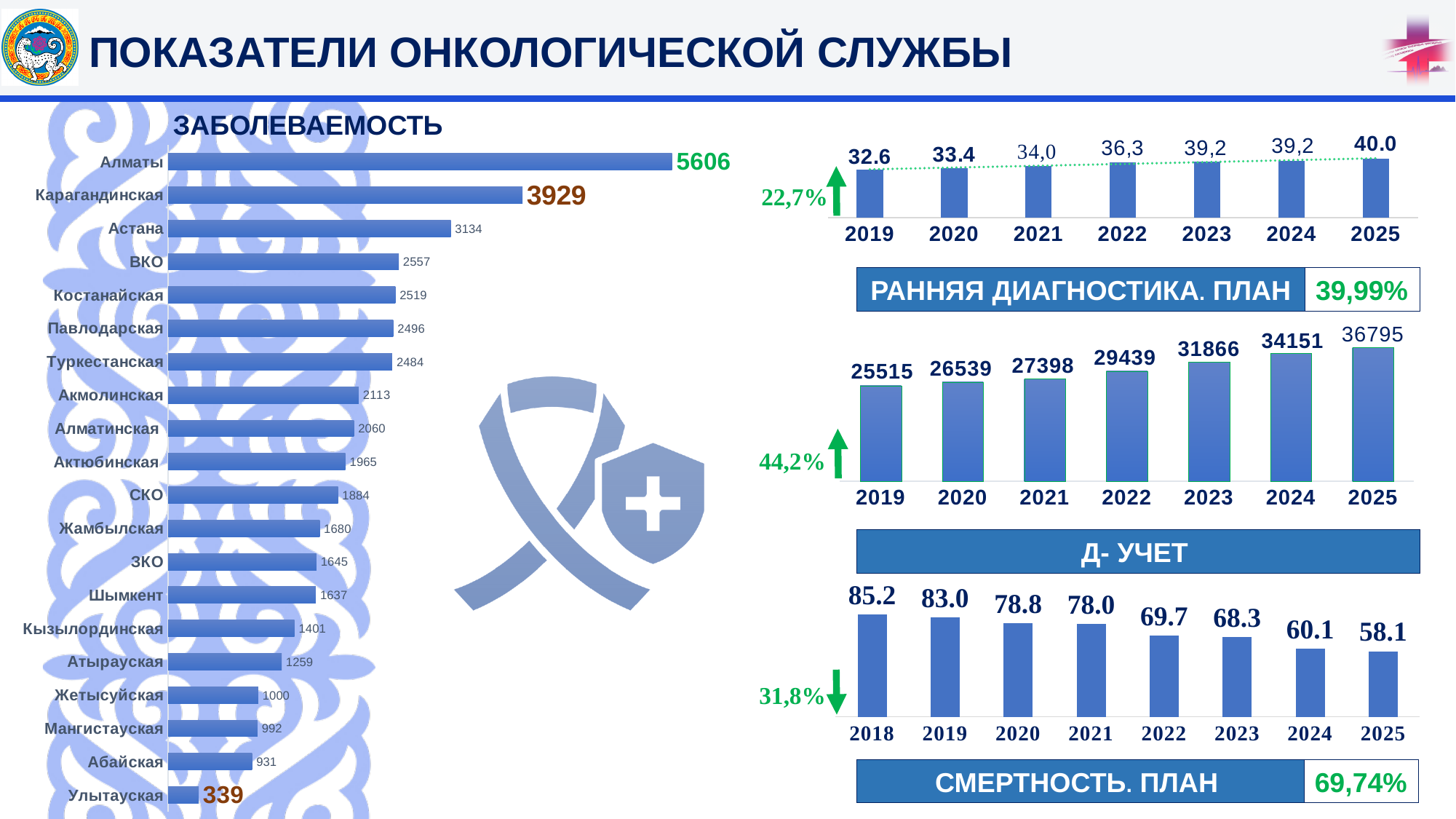
In the ЗАБОЛЕВАЕМОСТЬ chart, how many regions are listed? 20 In the ЗАБОЛЕВАЕМОСТЬ chart, what is the difference between Алматы and Карагандинская? 1677 In the top-right chart (above РАННЯЯ ДИАГНОСТИКА. ПЛАН), what is the value for 2025? 40.0 In the ЗАБОЛЕВАЕМОСТЬ chart, which is larger, Астана or ВКО? Астана In the ЗАБОЛЕВАЕМОСТЬ chart, which region has the lowest value? Улытауская In the top-right chart (above РАННЯЯ ДИАГНОСТИКА. ПЛАН), do the values rise or fall from 2019 to 2025? rise In the ЗАБОЛЕВАЕМОСТЬ chart, what is the value for Жетысуйская? 1000 What type of chart is the ЗАБОЛЕВАЕМОСТЬ chart? bar chart In the ЗАБОЛЕВАЕМОСТЬ chart, what is the value for Алматы? 5606 In the bottom-right chart (above СМЕРТНОСТЬ. ПЛАН), which year has the highest value? 2018 In the Д- УЧЕТ chart (middle right), what is the value for 2023? 31866 In the Д- УЧЕТ chart (middle right), what is the difference between 2025 and 2019? 11280